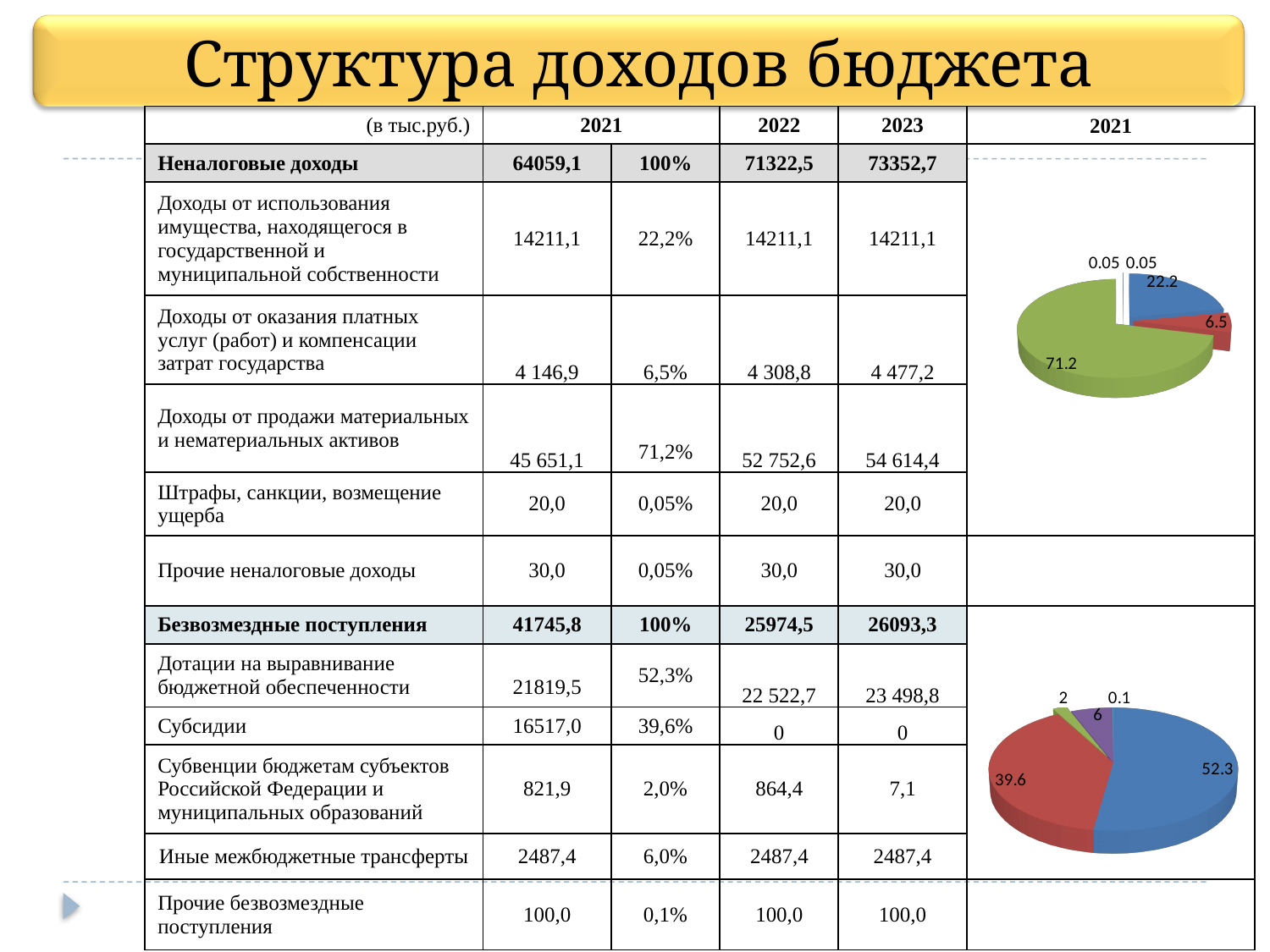
What type of chart is the bottom chart on the right side of the slide? pie chart In the top pie chart, what value is labelled on the blue slice? 22.2 In the bottom pie chart, what value is labelled on the red slice? 39.6 What type of chart is the top chart on the right side of the slide? pie chart How many slices are labelled in the bottom pie chart? 5 In the bottom pie chart, what is the value shown on the largest (blue) slice? 52.3 In the top pie chart, what is the difference between the values labelled 22.2 and 6.5? 15.7 In the bottom pie chart, which is larger: the blue slice (52.3) or the red slice (39.6)? blue slice (52.3) In the top pie chart, what is the value shown on the largest (green) slice? 71.2 How many slices are labelled in the top pie chart? 5 In the top pie chart, what value is labelled on the red slice? 6.5 In the bottom pie chart, what is the smallest labelled value? 0.1